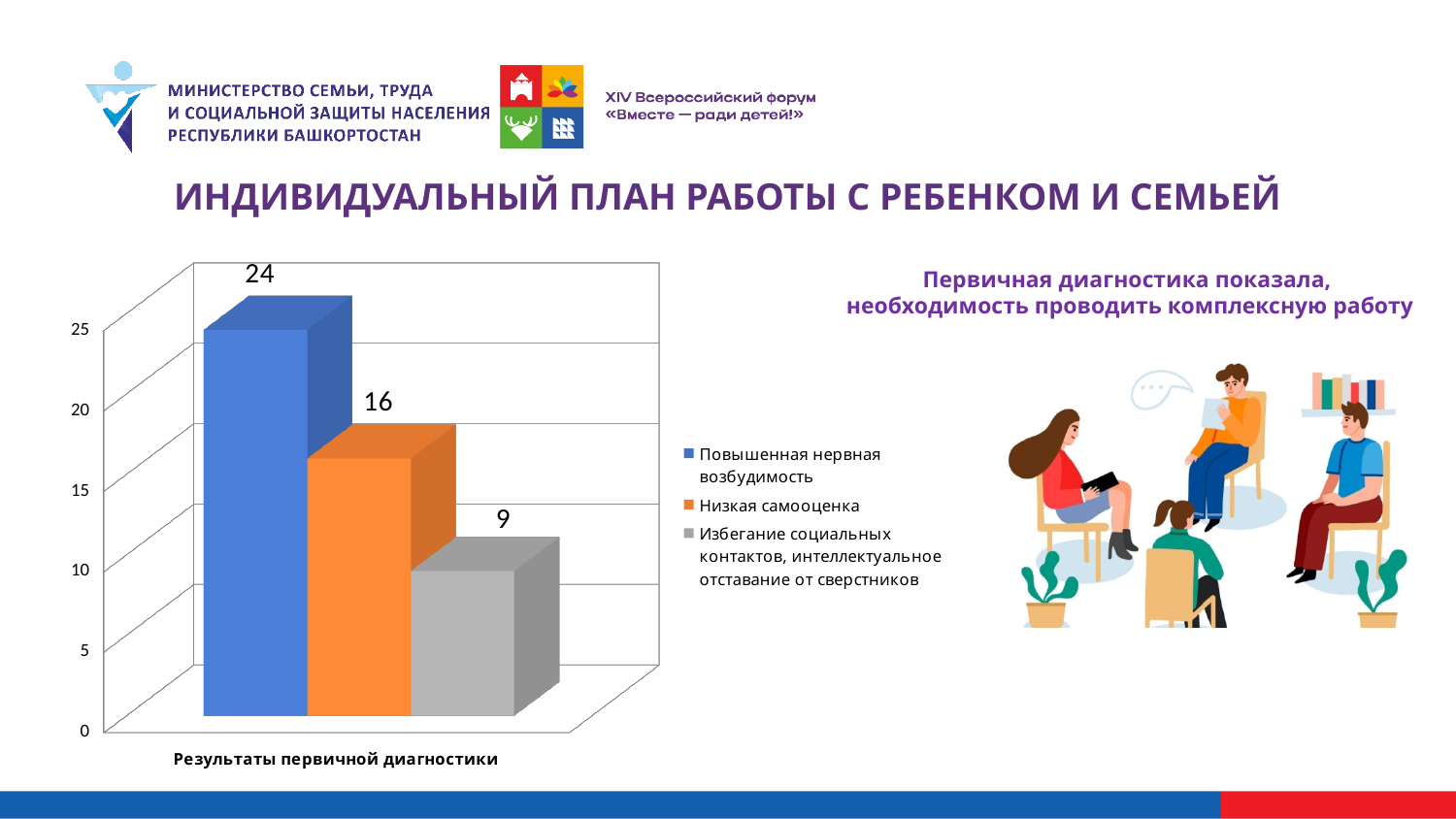
Which series has the highest value? Повышенная нервная возбудимость What value is shown for "Повышенная нервная возбудимость"? 24 What is the difference between the values for "Низкая самооценка" and "Избегание социальных контактов, интеллектуальное отставание от сверстников"? 7 Which is larger: the value for "Низкая самооценка" or for "Избегание социальных контактов, интеллектуальное отставание от сверстников"? Низкая самооценка What kind of chart is shown on the slide? bar chart What is the label shown on the horizontal axis of the chart? Результаты первичной диагностики Which series has the lowest value? Избегание социальных контактов, интеллектуальное отставание от сверстников What is the difference between the values for "Повышенная нервная возбудимость" and "Низкая самооценка"? 8 Is the value for "Повышенная нервная возбудимость" greater or less than 20? greater What value is shown for "Низкая самооценка"? 16 How many series does the legend list? 3 What value is shown for "Избегание социальных контактов, интеллектуальное отставание от сверстников"? 9